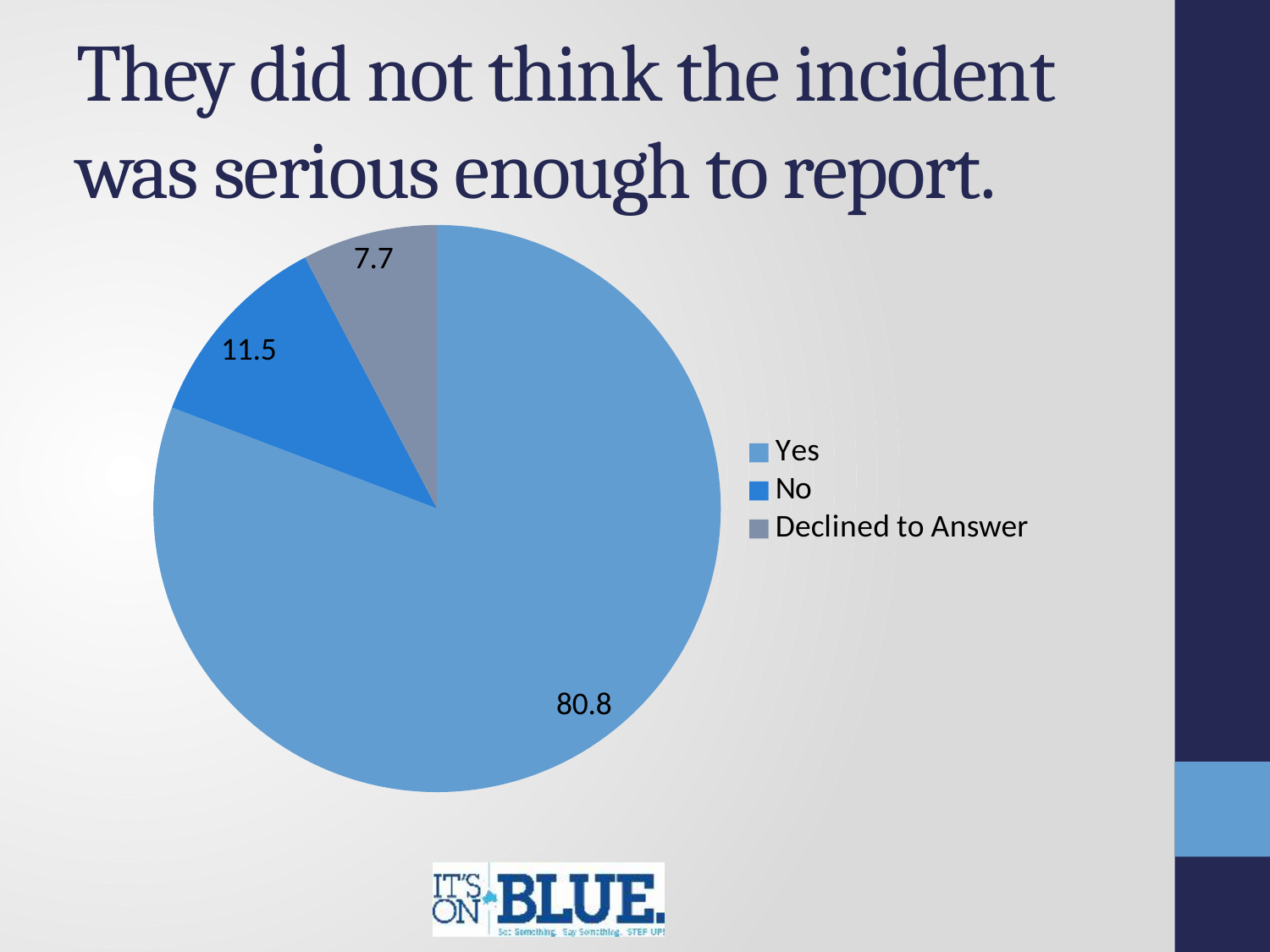
What is the difference between the No value and the Declined to Answer value? 3.8 Which category has the largest slice of the pie chart? Yes How many slices does the pie chart have? 3 What value is shown for the Declined to Answer slice of the pie chart? 7.7 What value is shown for the Yes slice of the pie chart? 80.8 What value is shown for the No slice of the pie chart? 11.5 What is the difference between the Yes value and the No value? 69.3 Which category has the smallest slice of the pie chart? Declined to Answer How many entries does the legend list? 3 What is the title of the slide containing the chart? They did not think the incident was serious enough to report. Which is larger, the No slice or the Declined to Answer slice? No What kind of chart is shown on the slide? Pie chart